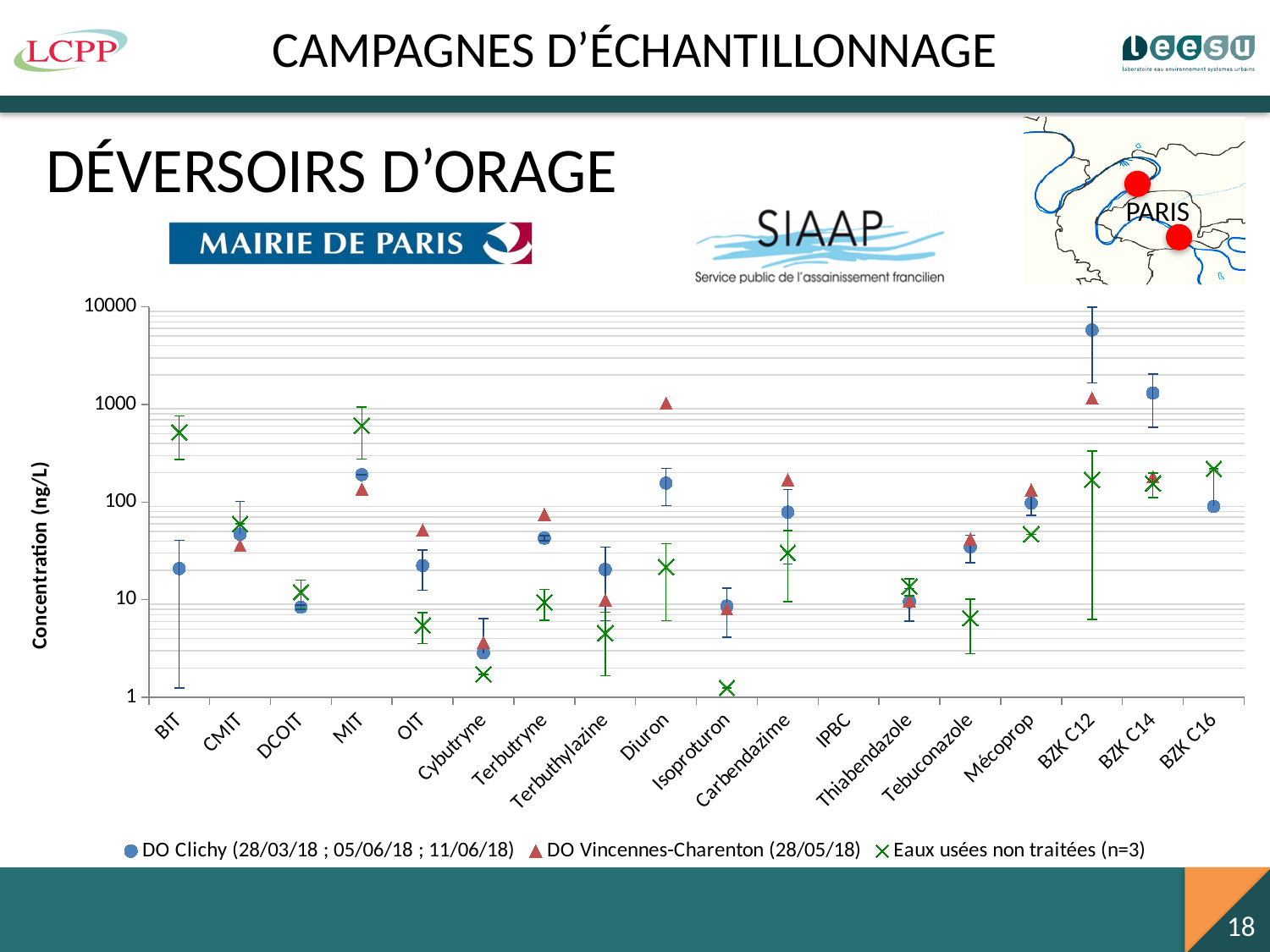
Which is larger for BIT: the DO Clichy value or the Eaux usées non traitées value? Eaux usées non traitées Which series in the legend is plotted with green crosses? Eaux usées non traitées (n=3) Is the DO Clichy value for Cybutryne greater or less than 10? less How many series does the chart legend list? 3 For which compound is the DO Clichy value highest? BZK C12 Is the Eaux usées non traitées value for BIT greater or less than 100? greater How many compound categories are listed along the x axis of the chart? 18 For which compound is the DO Clichy value lowest? Cybutryne What kind of chart is shown on the slide? Scatter plot What is the label of the y axis of the chart? Concentration (ng/L) For which compound is the Eaux usées non traitées value lowest? Isoproturon Is the DO Clichy value for BZK C12 greater or less than 1000? greater